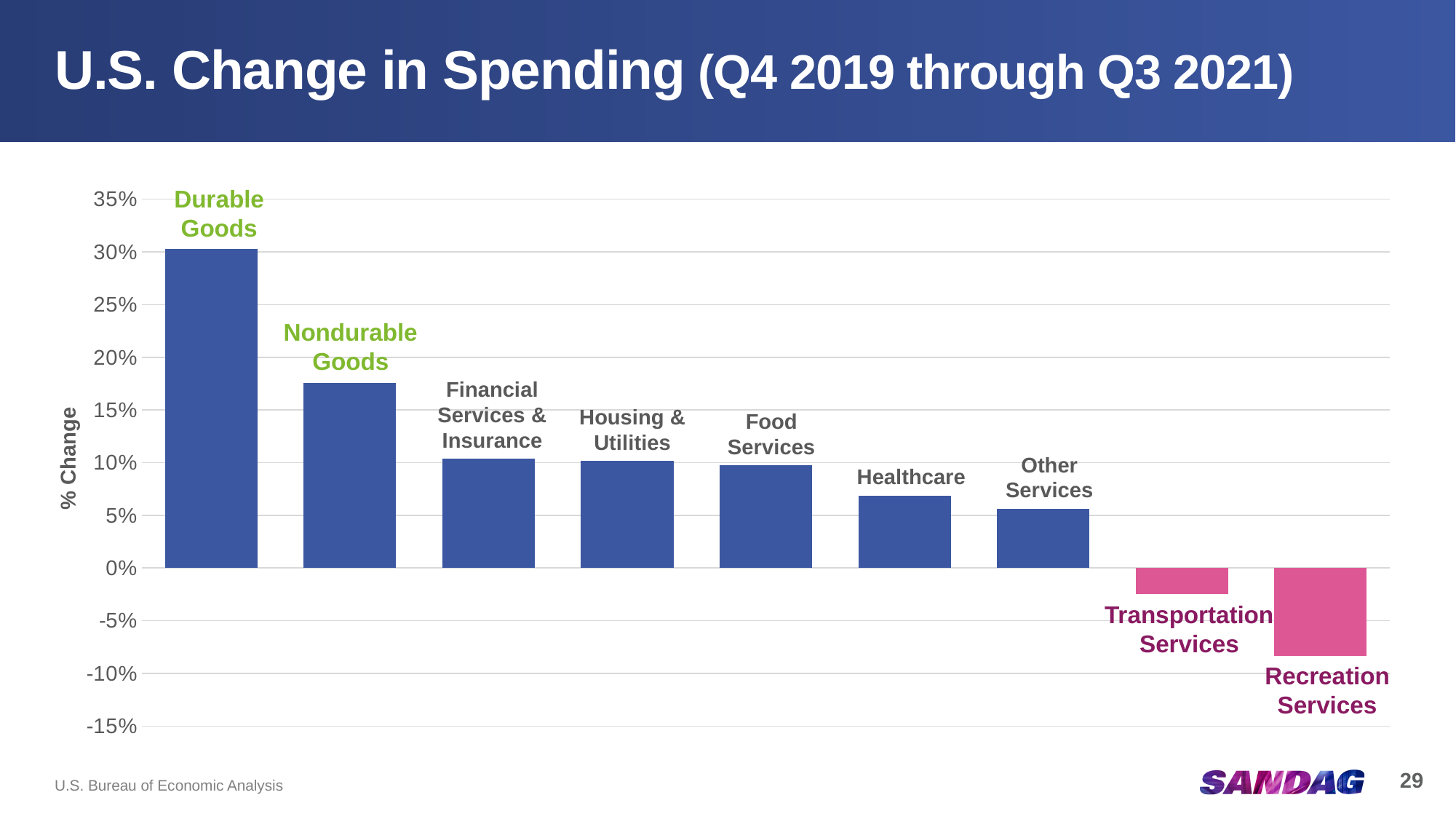
Which is larger, the value for Nondurable Goods or the value for Housing & Utilities? Nondurable Goods Do the values rise or fall moving from left to right across the categories? fall How many spending categories are plotted in the chart? 9 What kind of chart is shown on the slide? bar chart Which category has the highest percent change in spending? Durable Goods Is the value for Nondurable Goods greater or less than 20%? less Is the value for Recreation Services greater or less than -5%? less Is the value for Durable Goods greater or less than 25%? greater What is the title of the vertical axis? % Change Which is larger, the value for Transportation Services or the value for Recreation Services? Transportation Services Which category has the lowest percent change in spending? Recreation Services